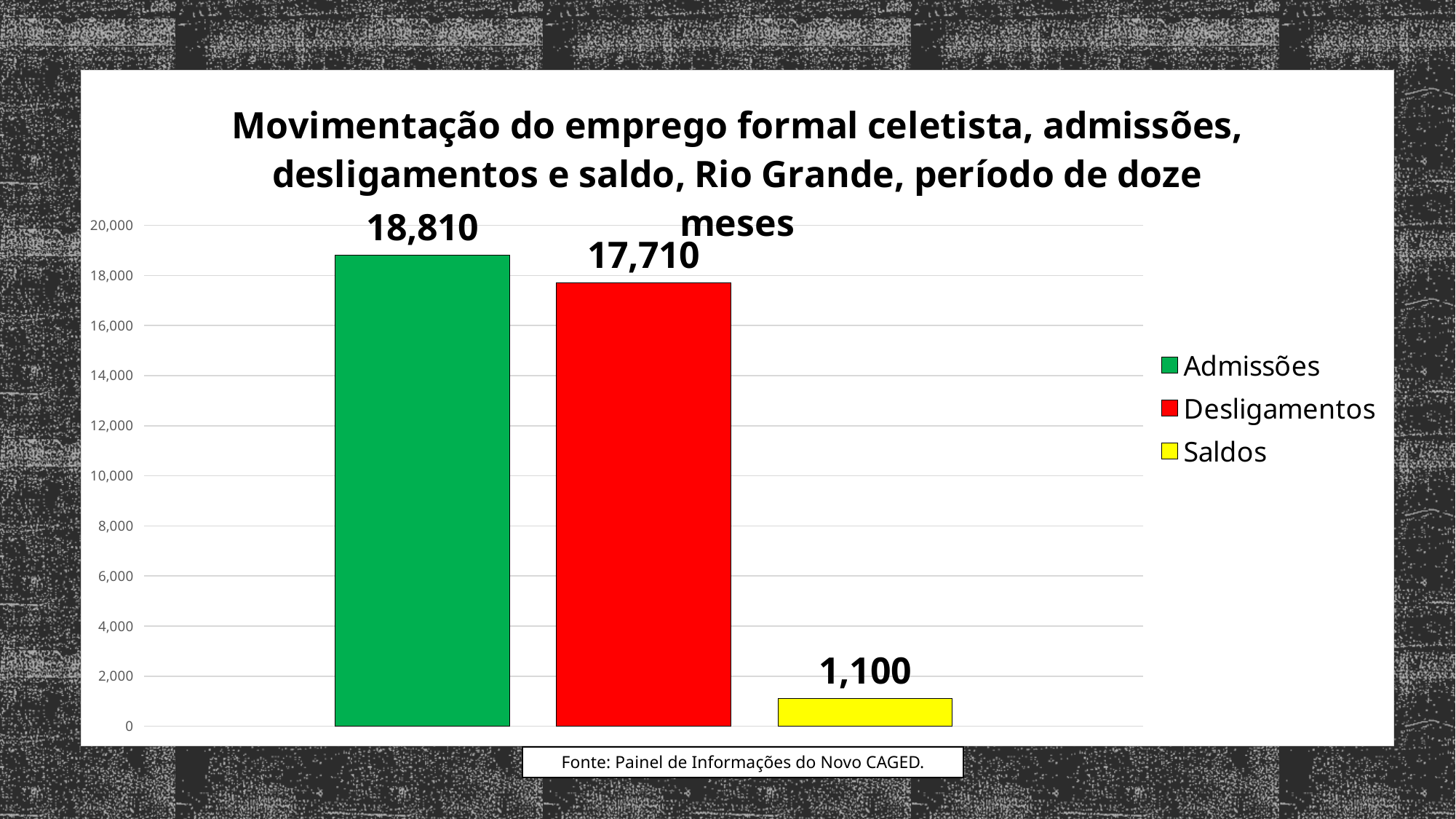
What is the difference between Admissões and Desligamentos? 1,100 Which series has the highest value? Admissões What kind of chart is shown? bar chart Which series has the lowest value? Saldos Is the value for Desligamentos greater or less than 16,000? greater How many series does the legend list? 3 What is the value for Desligamentos? 17,710 What is the value for Saldos? 1,100 What colour is the bar for Saldos? yellow What is the value for Admissões? 18,810 Which is larger, Desligamentos or Saldos? Desligamentos Is the value for Saldos greater or less than 2,000? less